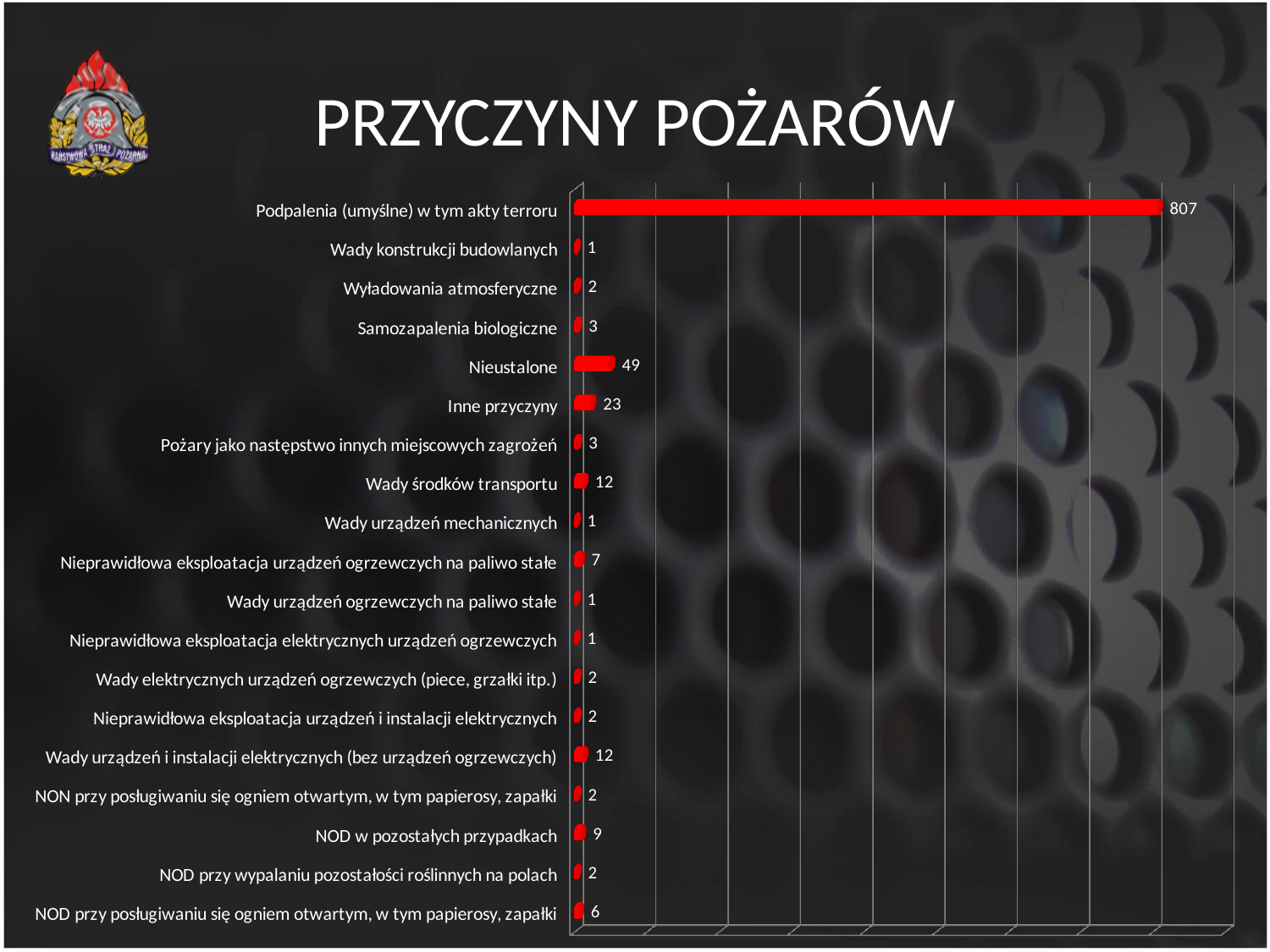
Which category has the highest value? Podpalenia (umyślne) w tym akty terroru How many categories are shown in the chart? 19 Which is larger, the value for "Nieustalone" or the value for "Inne przyczyny"? Nieustalone What is the title of the chart? PRZYCZYNY POŻARÓW What is the difference between the values for "Podpalenia (umyślne) w tym akty terroru" and "Nieustalone"? 758 What is the value for "Inne przyczyny"? 23 What is the value for "NOD w pozostałych przypadkach"? 9 What is the value for "Wady środków transportu"? 12 What is the value for "Nieustalone"? 49 What is the difference between the values for "Nieustalone" and "Inne przyczyny"? 26 What is the value for "Podpalenia (umyślne) w tym akty terroru"? 807 What type of chart is shown on the slide? bar chart